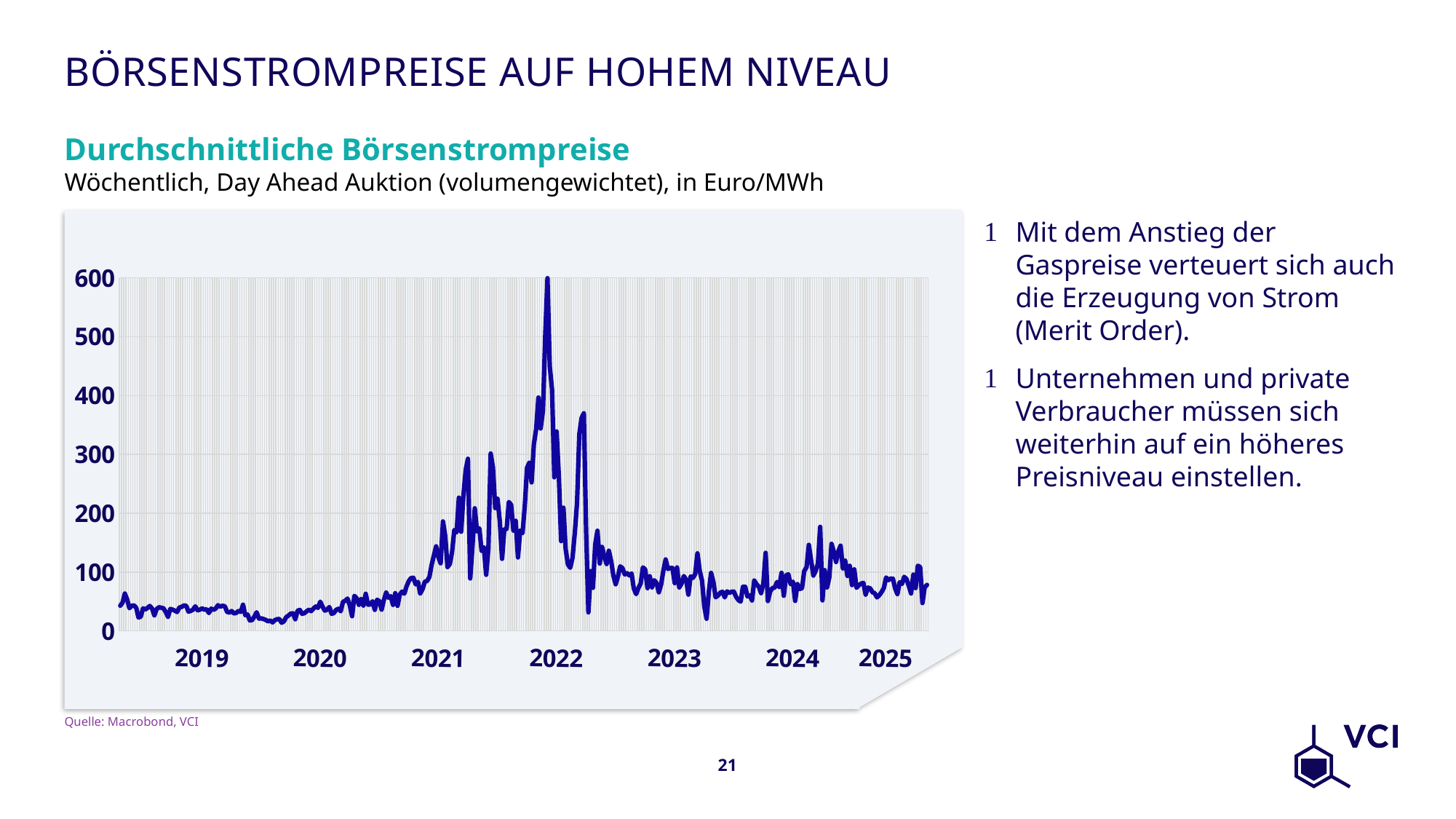
Do the values rise or fall from the 2022 peak to 2023? fall Which is larger: the peak value in 2022 or the values in 2019? the peak value in 2022 Are the values during 2020 greater or less than 100? less In which unit are the electricity prices on the chart given? Euro/MWh Is the highest peak of the line in 2022 greater or less than 500? greater What is the highest value labelled on the y axis? 600 In which year does the line reach its highest peak? 2022 What is the title of the chart? Durchschnittliche Börsenstrompreise Are the values during 2019 greater or less than 100? less Do the values rise or fall from 2020 to the peak in 2022? rise How many year labels are shown on the x axis? 7 What kind of chart is shown on the slide? line chart